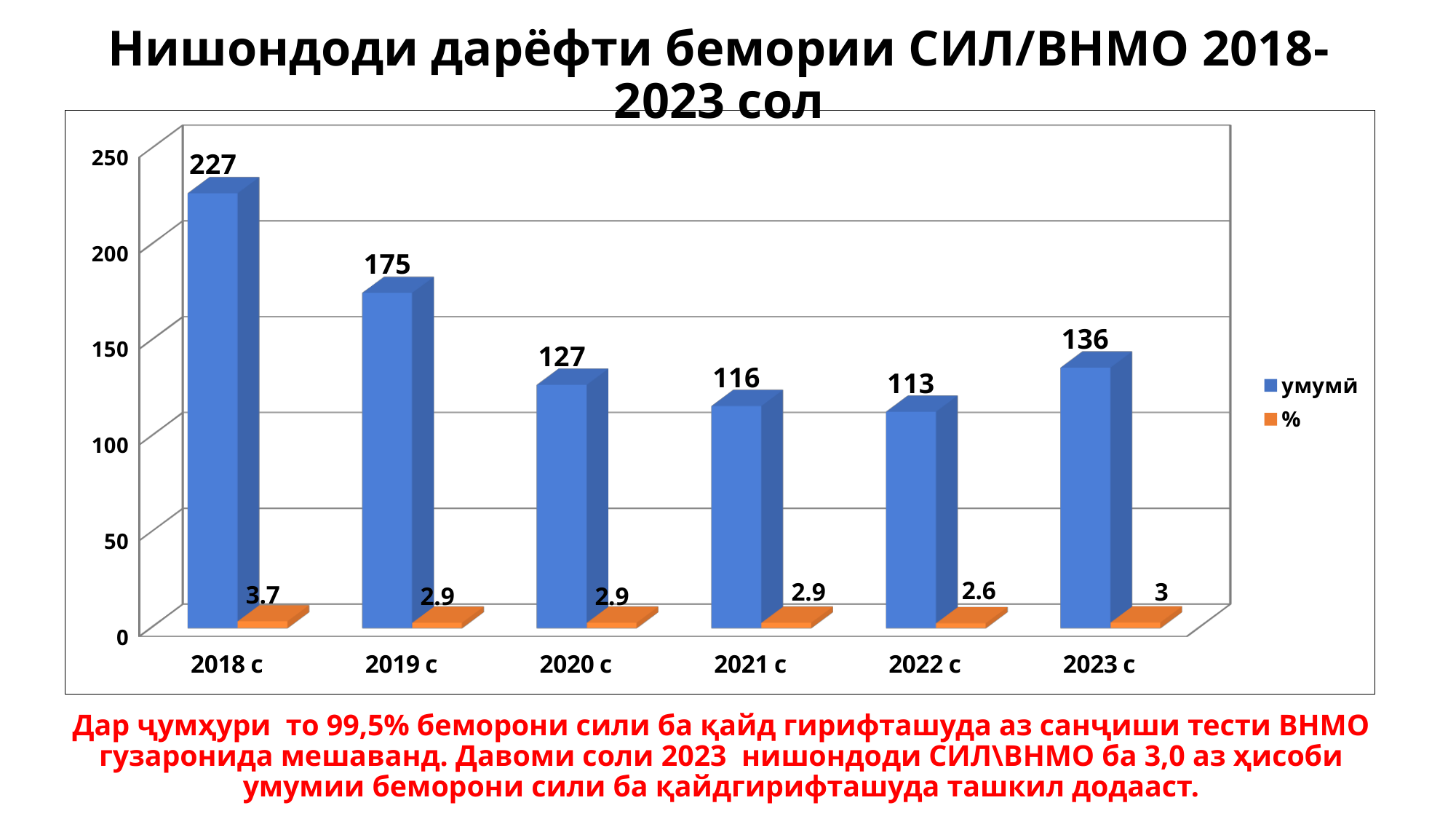
What kind of chart is shown on the slide? bar chart Which year has the lowest умумӣ value? 2022 с What is the difference between the умумӣ values for 2018 с and 2019 с? 52 What is the % value for 2022 с? 2.6 Which is larger, the умумӣ value for 2020 с or for 2023 с? 2023 с How many years are shown on the x axis? 6 What is the умумӣ value for 2023 с? 136 Which year has the highest умумӣ value? 2018 с What colour are the bars for the % series? orange How many series does the legend list? 2 Does the умумӣ series rise or fall from 2018 с to 2022 с? fall What is the value of the умумӣ series for 2018 с? 227